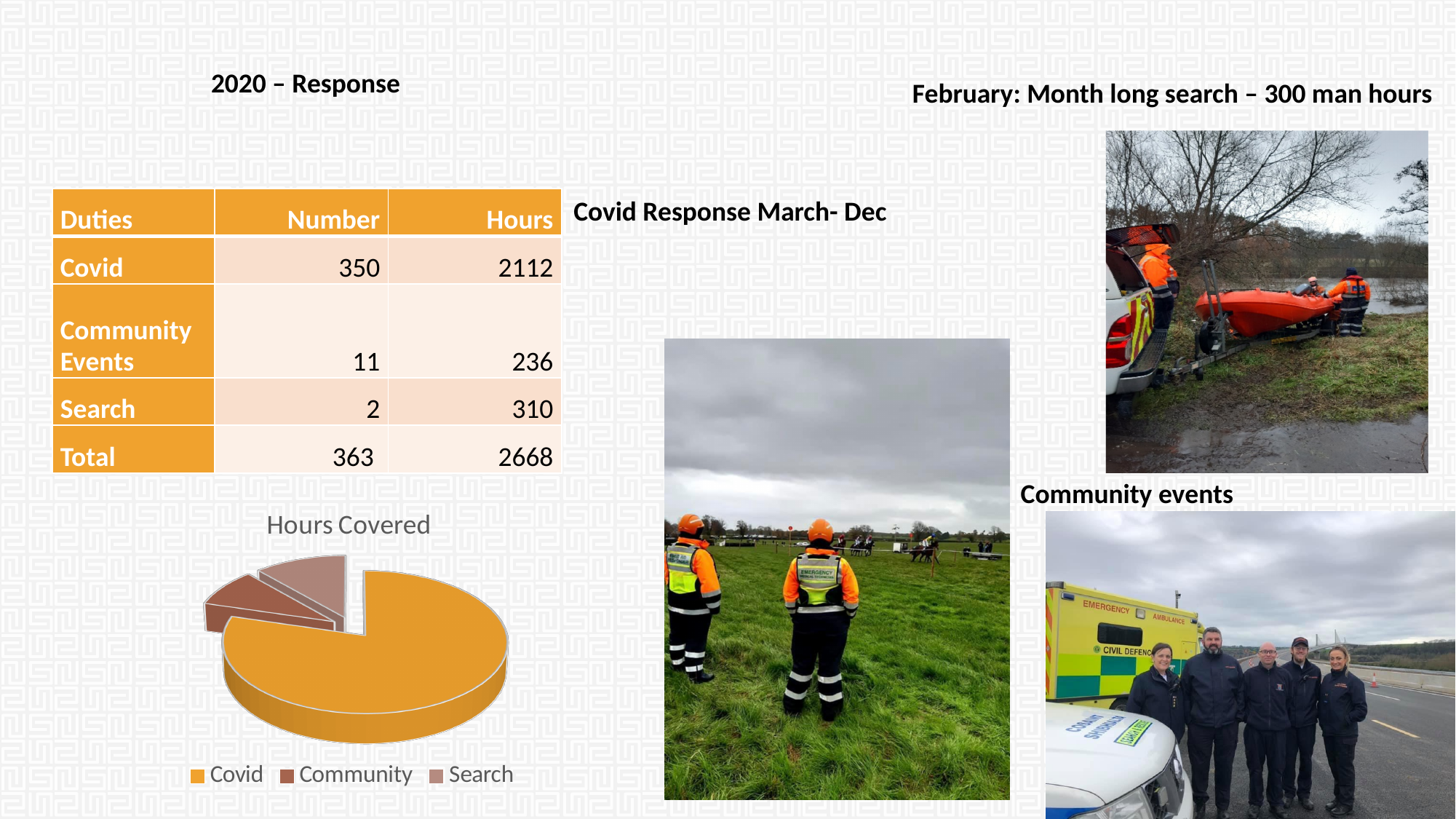
How many slices does the "Hours Covered" pie chart have? 3 What is the title of the pie chart on the slide? Hours Covered How many entries does the legend of the "Hours Covered" pie chart list? 3 Which category has the largest slice in the "Hours Covered" pie chart? Covid What kind of chart is the "Hours Covered" chart? Pie chart In the "Hours Covered" pie chart, which slice is larger, Covid or Community? Covid What are the three categories listed in the legend of the "Hours Covered" pie chart? Covid, Community, Search In the "Hours Covered" pie chart, which slice is larger, Covid or Search? Covid